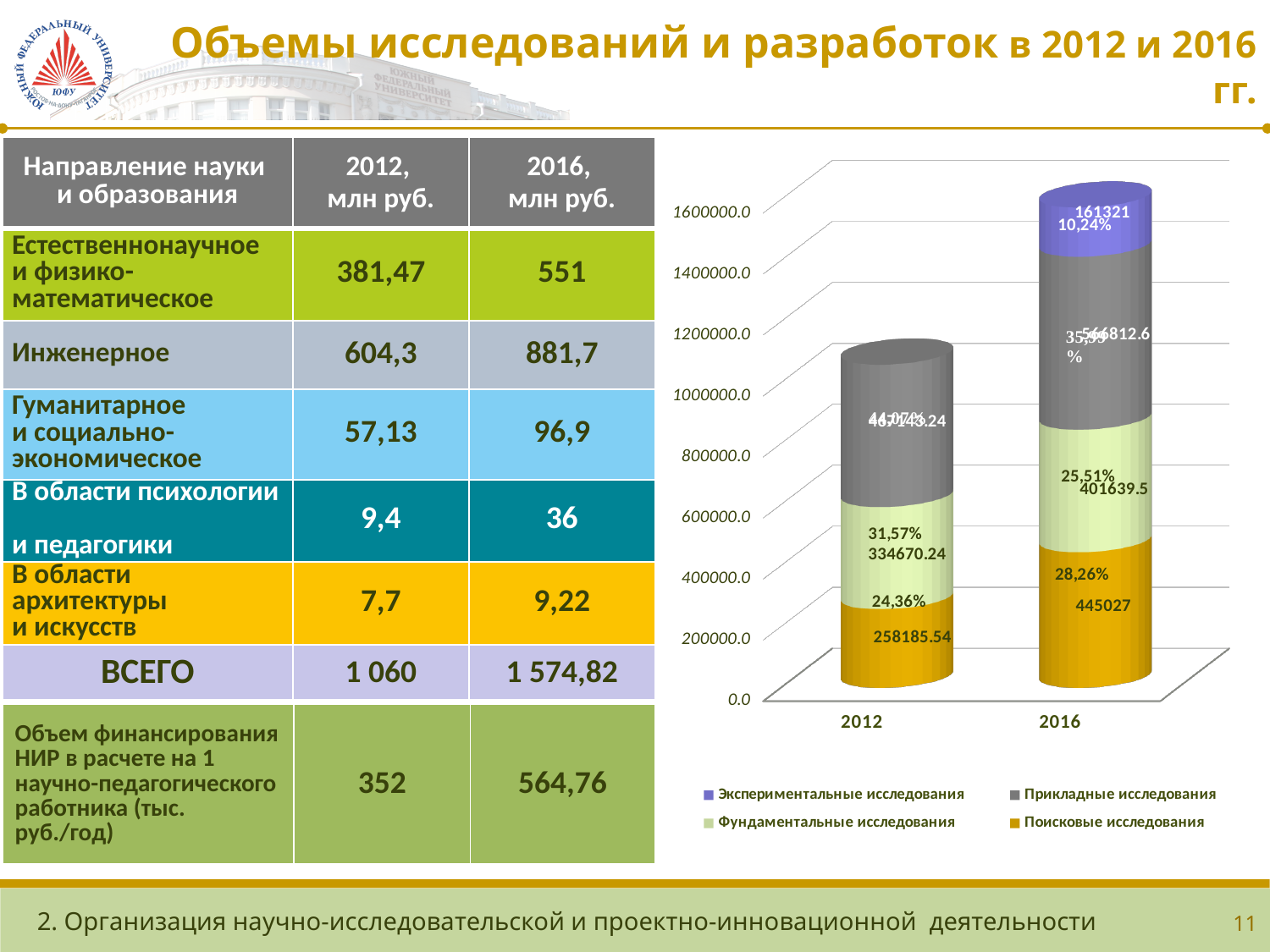
What percentage share does Поисковые исследования have in the 2012 bar? 24,36% Which is larger, Поисковые исследования in 2012 or in 2016? 2016 What percentage share does Экспериментальные исследования have in the 2016 bar? 10,24% What kind of chart is shown on the right side of the slide? Stacked bar chart Which year has the taller stacked bar? 2016 How many years (categories) are shown on the x axis of the chart? 2 What is the value of Экспериментальные исследования for 2016? 161321 What is the value of Фундаментальные исследования for 2016? 401639.5 How many series does the chart legend list? 4 What is the difference between Поисковые исследования in 2016 and in 2012? 186841.46 What is the value of Поисковые исследования for 2012? 258185.54 Is the total height of the 2016 bar greater or less than 1400000.0? greater